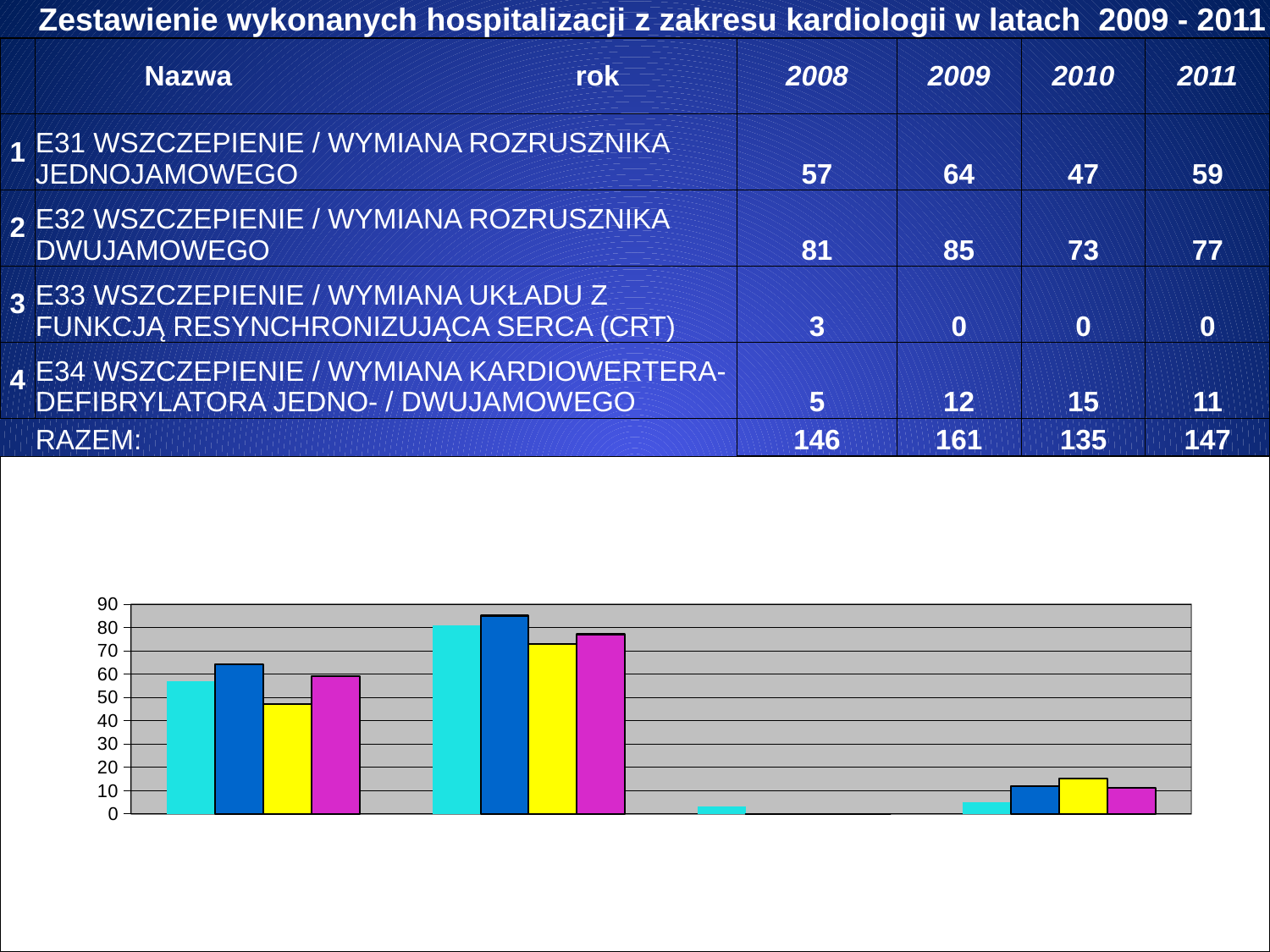
In the chart, is the third (yellow) bar of the first group greater or less than 50? less In the chart, is the tallest bar of the second group greater or less than 80? greater Which group of bars in the chart contains the tallest bar? the second group What is the highest value shown on the chart's vertical axis? 90 What kind of chart is shown at the bottom of the slide? bar chart Which group of bars in the chart has the lowest bars overall? the third group How many groups of bars does the chart contain? 4 In the second group of the chart, which is taller: the second (blue) bar or the third (yellow) bar? the second (blue) bar In the chart, is the tallest bar of the fourth group greater or less than 20? less How many bars are there in each group of the chart? 4 What is the interval between tick marks on the chart's vertical axis? 10